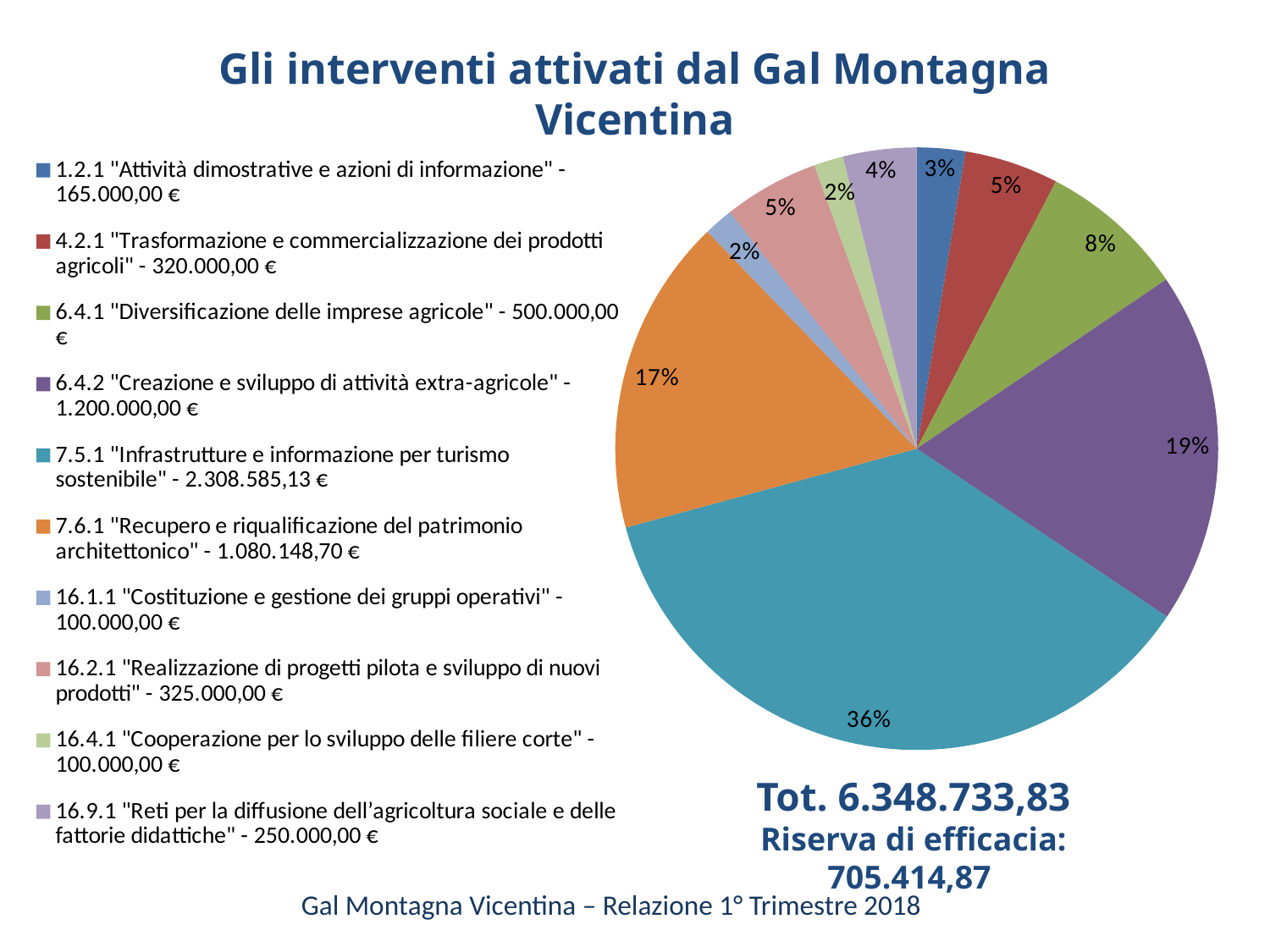
What is the title of the chart on the slide? Gli interventi attivati dal Gal Montagna Vicentina How many slices does the pie chart have? 10 What share of the pie does 1.2.1 "Attività dimostrative e azioni di informazione" represent? 3% What kind of chart is shown on the slide? pie chart What share of the pie does 7.6.1 "Recupero e riqualificazione del patrimonio architettonico" represent? 17% Which has the larger share of the pie: 6.4.1 "Diversificazione delle imprese agricole" or 16.9.1 "Reti per la diffusione dell'agricoltura sociale e delle fattorie didattiche"? 6.4.1 "Diversificazione delle imprese agricole" What is the difference in percentage points between the share of 7.5.1 "Infrastrutture e informazione per turismo sostenibile" and the share of 6.4.2 "Creazione e sviluppo di attività extra-agricole"? 17 According to the legend, what amount is associated with 6.4.2 "Creazione e sviluppo di attività extra-agricole"? 1.200.000,00 € According to the legend, what amount is associated with 7.5.1 "Infrastrutture e informazione per turismo sostenibile"? 2.308.585,13 € What share of the pie does 7.5.1 "Infrastrutture e informazione per turismo sostenibile" represent? 36% Which intervention has the largest share of the pie? 7.5.1 "Infrastrutture e informazione per turismo sostenibile"